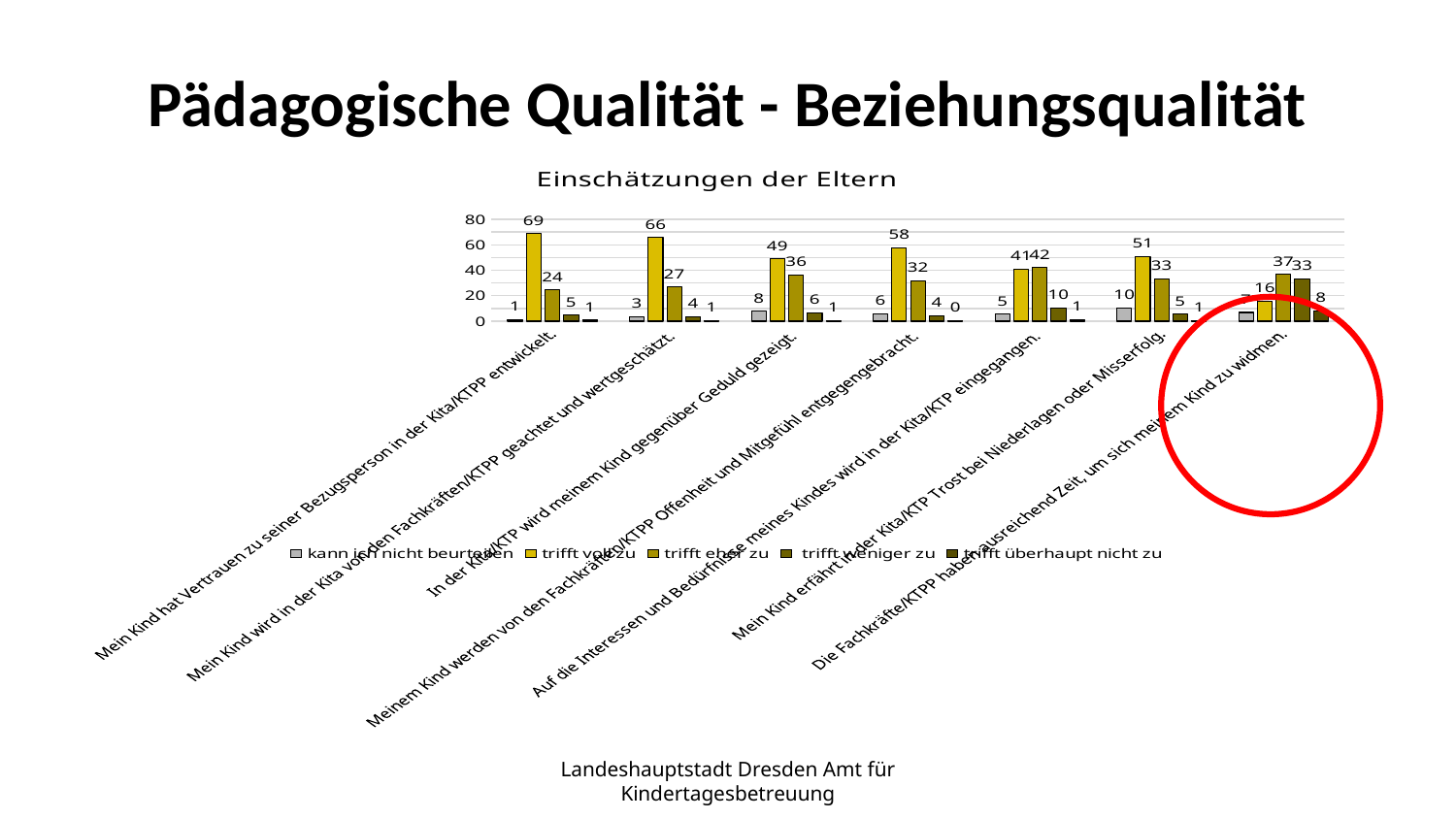
For "In der Kita/KTP wird meinem Kind gegenüber Geduld gezeigt.", which is larger: "trifft voll zu" or "trifft eher zu"? trifft voll zu What is the value of "trifft voll zu" for "Mein Kind hat Vertrauen zu seiner Bezugsperson in der Kita/KTPP entwickelt."? 69 How many categories (statements) are shown on the x axis? 7 What is the value of "trifft weniger zu" for "Auf die Interessen und Bedürfnisse meines Kindes wird in der Kita/KTP eingegangen."? 10 What type of chart is shown on the slide? bar chart What is the value of "kann ich nicht beurteilen" for "Mein Kind erfährt in der Kita/KTP Trost bei Niederlagen oder Misserfolg."? 10 What is the value of "trifft eher zu" for "Die Fachkräfte/KTPP haben ausreichend Zeit, um sich meinem Kind zu widmen."? 37 What is the difference between the "trifft voll zu" and "trifft eher zu" values for "Mein Kind wird in der Kita von den Fachkräften/KTPP geachtet und wertgeschätzt."? 39 How many series does the legend list? 5 Which statement has the highest "trifft voll zu" value? Mein Kind hat Vertrauen zu seiner Bezugsperson in der Kita/KTPP entwickelt. Which statement has the lowest "trifft voll zu" value? Die Fachkräfte/KTPP haben ausreichend Zeit, um sich meinem Kind zu widmen. What is the title of the chart? Einschätzungen der Eltern